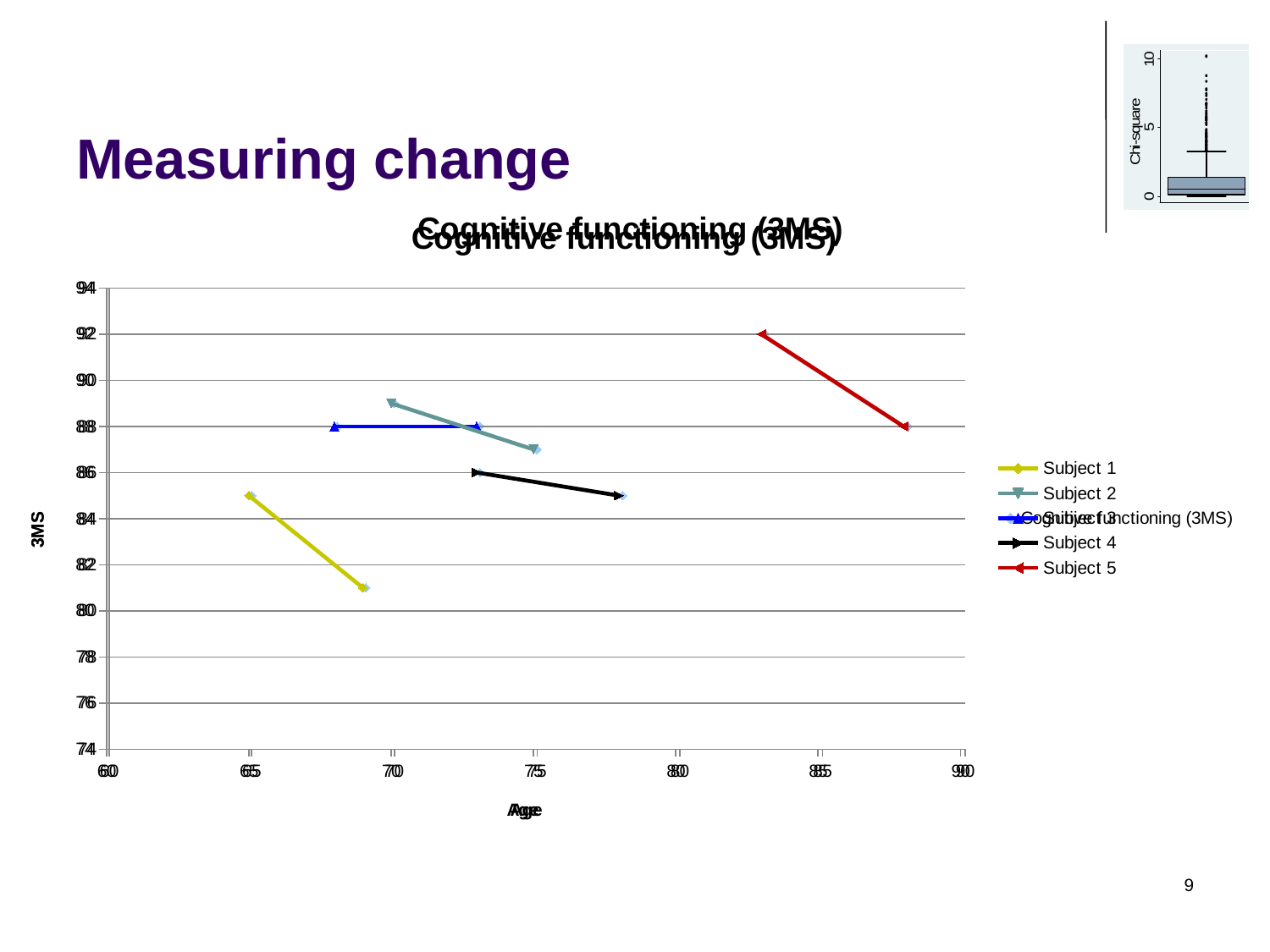
Is the final 3MS value for Subject 1 greater or less than 84? less How many subjects are plotted as lines in the main chart? 5 At what 3MS value does Subject 3's line stay flat? 88 Does Subject 5's 3MS score rise or fall as age increases? fall What kind of chart is shown on the slide under the heading 'Measuring change'? line chart What is the label of the x axis of the main chart? Age Is the starting 3MS value for Subject 5 greater or less than 90? greater Which subject has the lowest 3MS value in the main chart? Subject 1 Which subject reaches the highest 3MS value in the main chart? Subject 5 Does Subject 1's 3MS score rise or fall as age increases? fall What is the highest 3MS value reached by Subject 5? 92 What is the title of the main chart? Cognitive functioning (3MS)